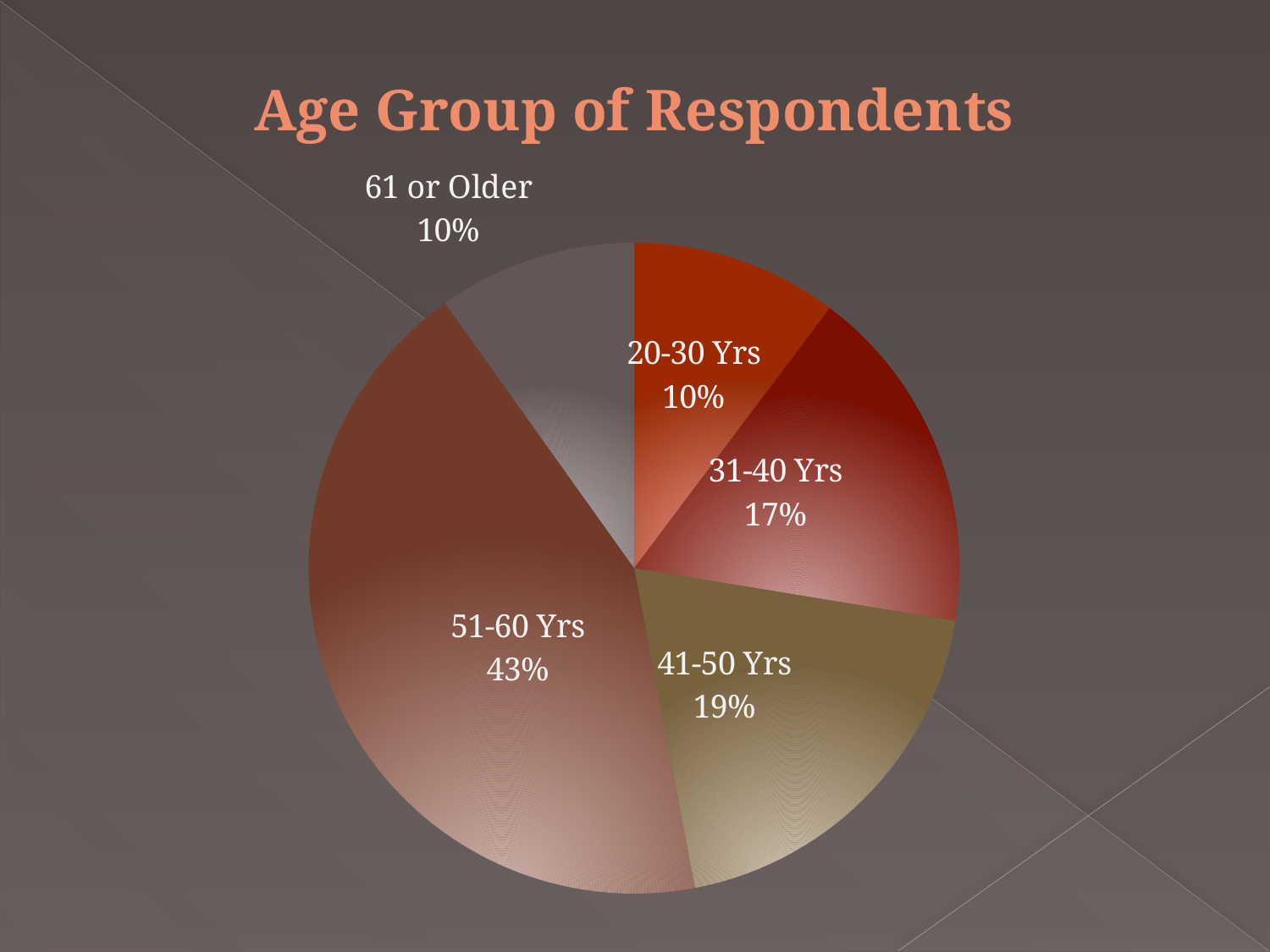
What share of respondents are 61 or Older? 10% How many age group slices does the pie chart have? 5 What share of respondents are in the 31-40 Yrs age group? 17% Which age group has the largest share of respondents? 51-60 Yrs Which slice is larger, 31-40 Yrs or 41-50 Yrs? 41-50 Yrs What kind of chart is shown on the slide? pie chart What is the difference in percentage points between the 31-40 Yrs and 20-30 Yrs slices? 7 What is the difference in percentage points between the 51-60 Yrs and 41-50 Yrs slices? 24 What share of respondents are in the 41-50 Yrs age group? 19% What is the title of the chart? Age Group of Respondents Which two age groups have the same share of respondents? 20-30 Yrs and 61 or Older